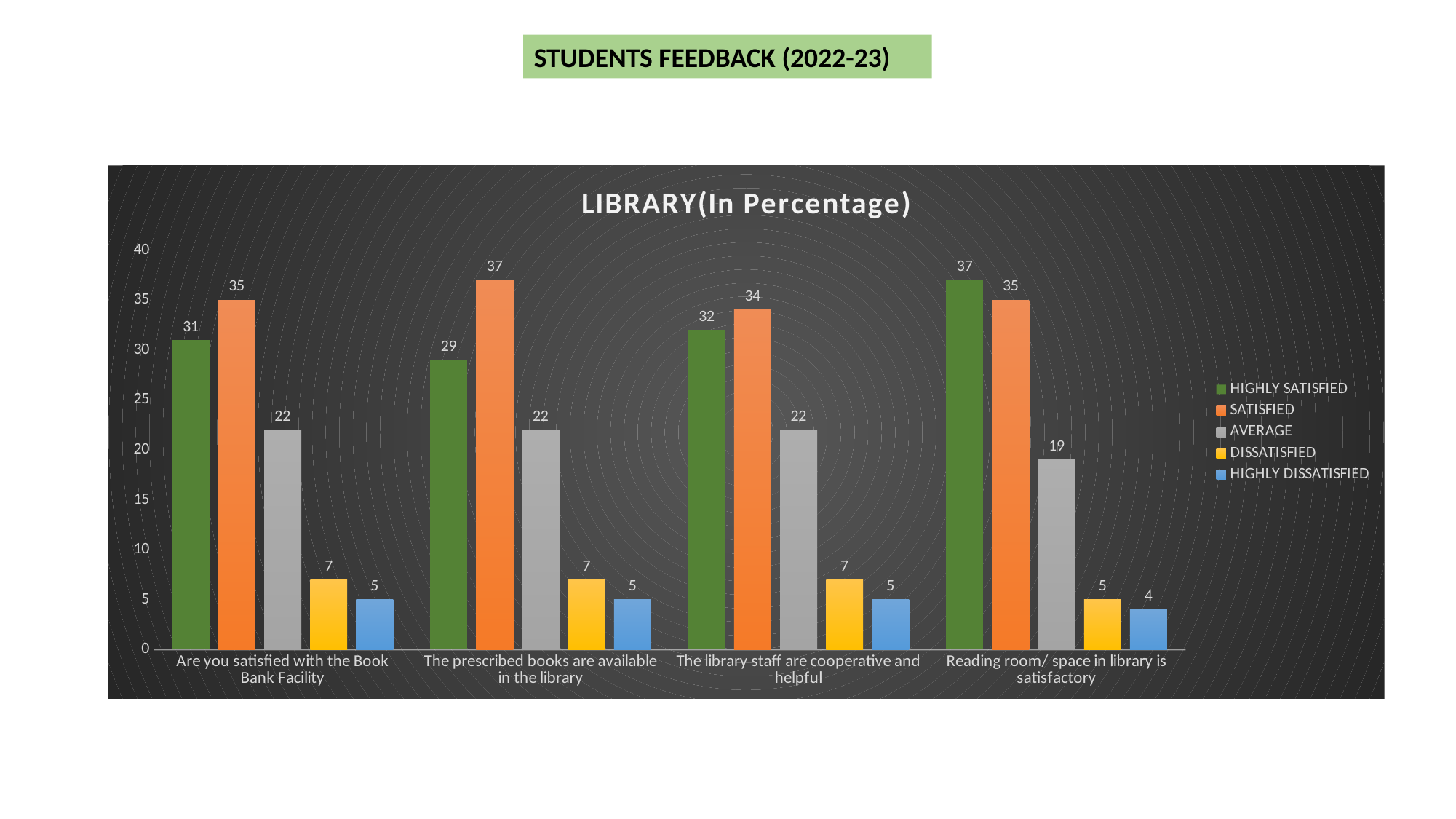
Which category has the lowest HIGHLY SATISFIED value? The prescribed books are available in the library How many series does the legend list? 5 What is the HIGHLY SATISFIED value for "Are you satisfied with the Book Bank Facility"? 31 What is the difference between the SATISFIED and HIGHLY SATISFIED values for "The prescribed books are available in the library"? 8 What is the AVERAGE value for "Reading room/ space in library is satisfactory"? 19 What is the SATISFIED value for "The prescribed books are available in the library"? 37 What is the HIGHLY DISSATISFIED value for "Reading room/ space in library is satisfactory"? 4 What is the title of the chart? LIBRARY(In Percentage) How many categories are shown on the x axis? 4 For "The library staff are cooperative and helpful", which is larger: HIGHLY SATISFIED or SATISFIED? SATISFIED What kind of chart is shown on the slide? Bar chart Which category has the highest HIGHLY SATISFIED value? Reading room/ space in library is satisfactory